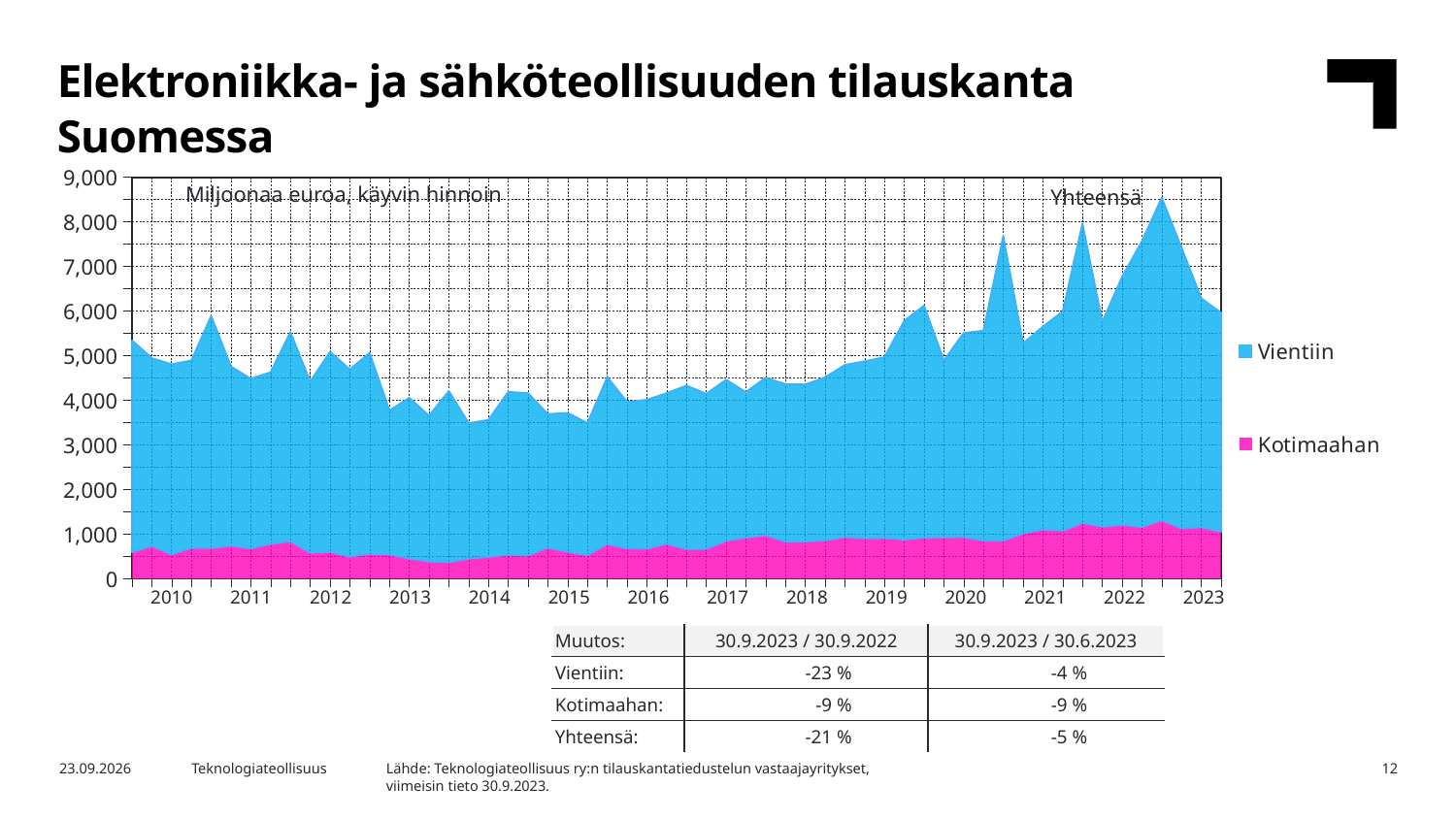
Is the total during 2014 greater or less than 5,000? less Is the Kotimaahan value in 2023 greater or less than 2,000? less Is the total (Yhteensä) at its peak in 2022 greater or less than 8,000? greater From 2019 to 2022, does the total order backlog generally rise or fall? rise What kind of chart is shown on the slide? Area chart In which year does the total reach its highest point on the chart? 2022 What are the two series named in the chart legend? Vientiin and Kotimaahan Which series is larger throughout the chart, Vientiin or Kotimaahan? Vientiin What unit note is printed inside the chart area at the top left? Miljoonaa euroa, käyvin hinnoin How many series does the chart legend list? 2